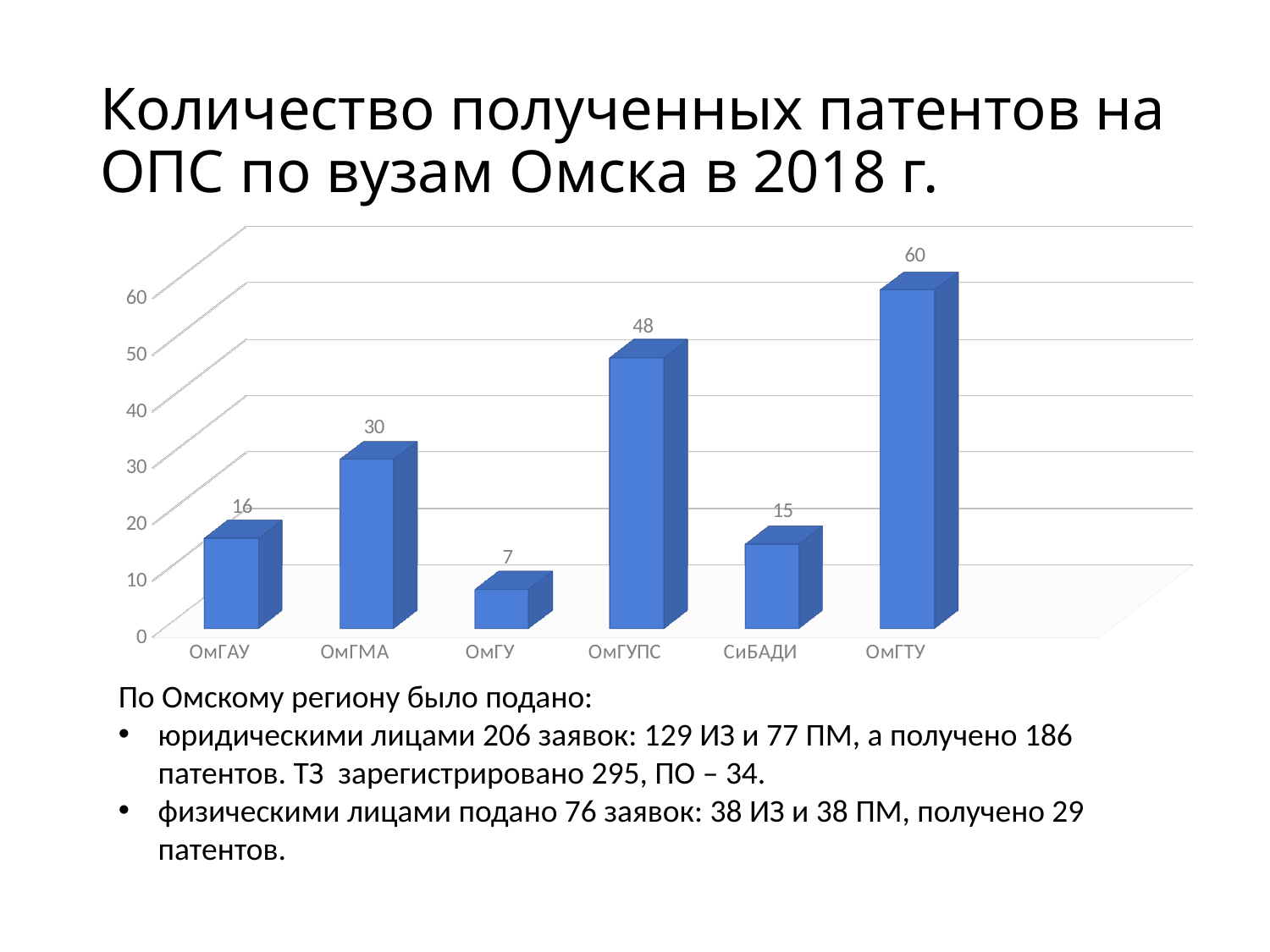
Is the value for ОмГМА greater or less than 20? greater Which has a larger value, ОмГАУ or СиБАДИ? ОмГАУ What is the value shown for СиБАДИ? 15 How many universities are shown on the x axis of the chart? 6 How many patents did ОмГУПС receive according to the chart? 48 What type of chart is shown on the slide? bar chart Which university has the lowest number of patents in the chart? ОмГУ What is the difference between the values for ОмГМА and ОмГАУ? 14 Which university has the highest number of patents in the chart? ОмГТУ What is the difference between the values for ОмГТУ and ОмГУПС? 12 What is the value shown for ОмГУ? 7 What is the title of the slide containing the chart? Количество полученных патентов на ОПС по вузам Омска в 2018 г.